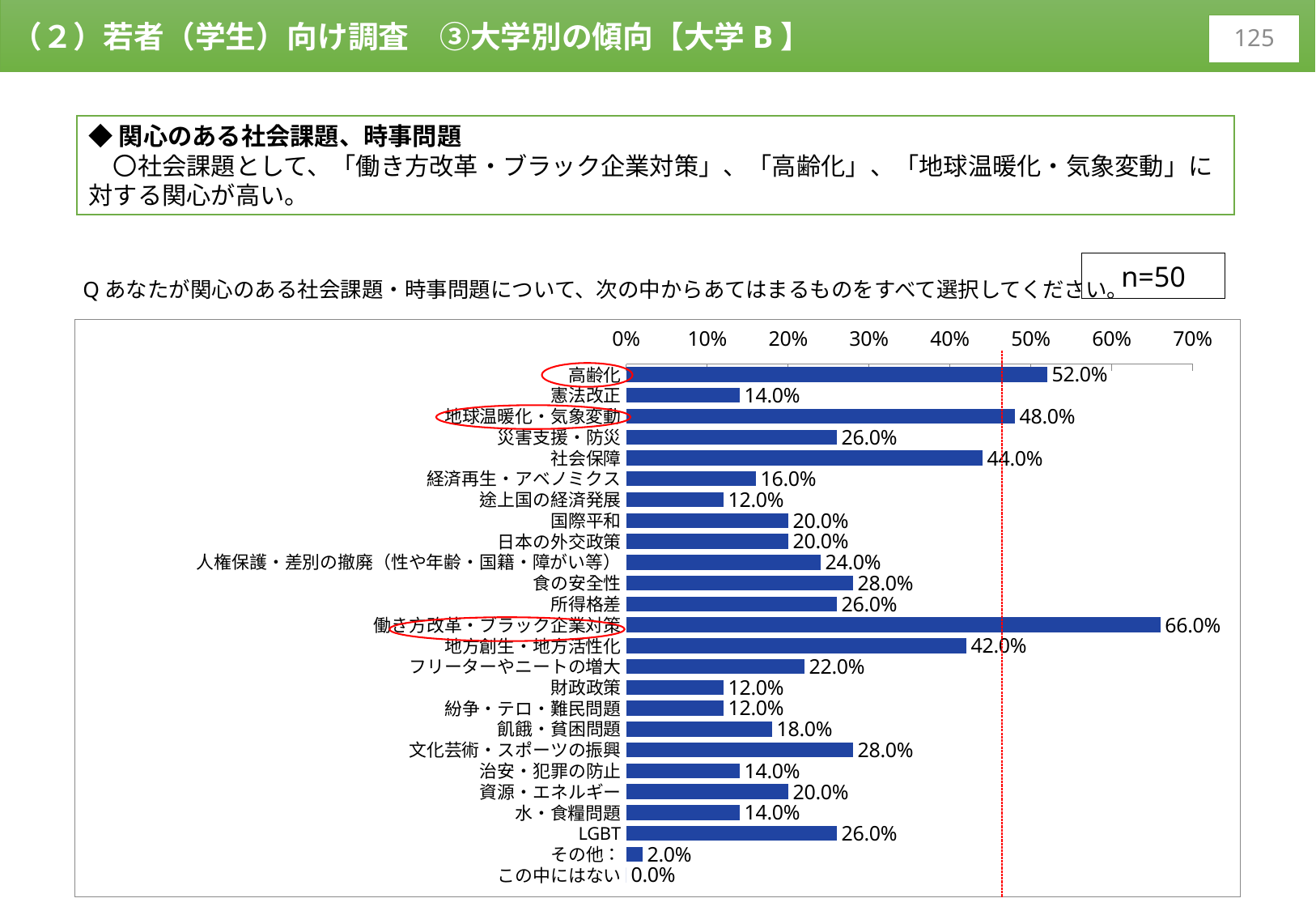
What is the difference between the values for 高齢化 and 地球温暖化・気象変動? 4.0% What is the sample size (n) shown on the slide? n=50 What is the value for その他：? 2.0% Which is larger, the value for 社会保障 or the value for 地方創生・地方活性化? 社会保障 Which category has the highest value? 働き方改革・ブラック企業対策 What is the value for 働き方改革・ブラック企業対策? 66.0% What is the value for 高齢化? 52.0% What kind of chart is shown on the slide? bar chart Is the value for 働き方改革・ブラック企業対策 greater or less than 60%? greater What is the value for 地方創生・地方活性化? 42.0% How many categories are shown in the chart? 25 Which category has the lowest value? この中にはない